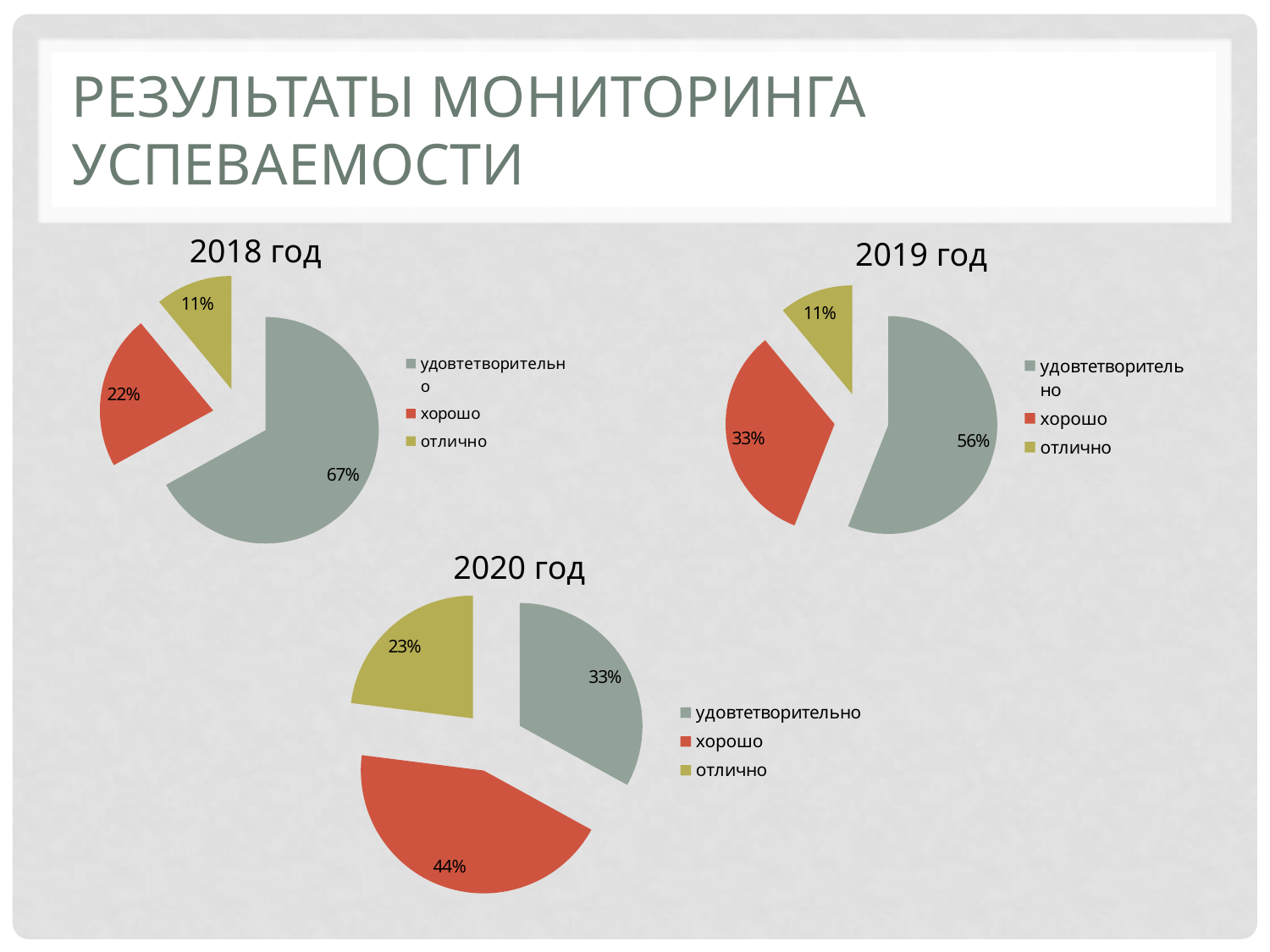
In the "2018 год" chart, what share does "хорошо" have? 22% In the "2019 год" chart, what share does "удовтетворительно" have? 56% In the "2019 год" chart, what is the difference between the shares of "удовтетворительно" and "хорошо"? 23% In the "2018 год" chart, which category has the smallest slice? отлично How many entries does the legend of the "2019 год" chart list? 3 In the "2020 год" chart, what share does "отлично" have? 23% In the "2020 год" chart, which is larger: the share of "хорошо" or the share of "удовтетворительно"? хорошо How many slices does the "2018 год" chart have? 3 How many charts are shown on the slide? 3 In the "2019 год" chart, which category has the largest slice? удовтетворительно In the "2020 год" chart, which category has the largest slice? хорошо What kind of chart is the "2020 год" chart? pie chart